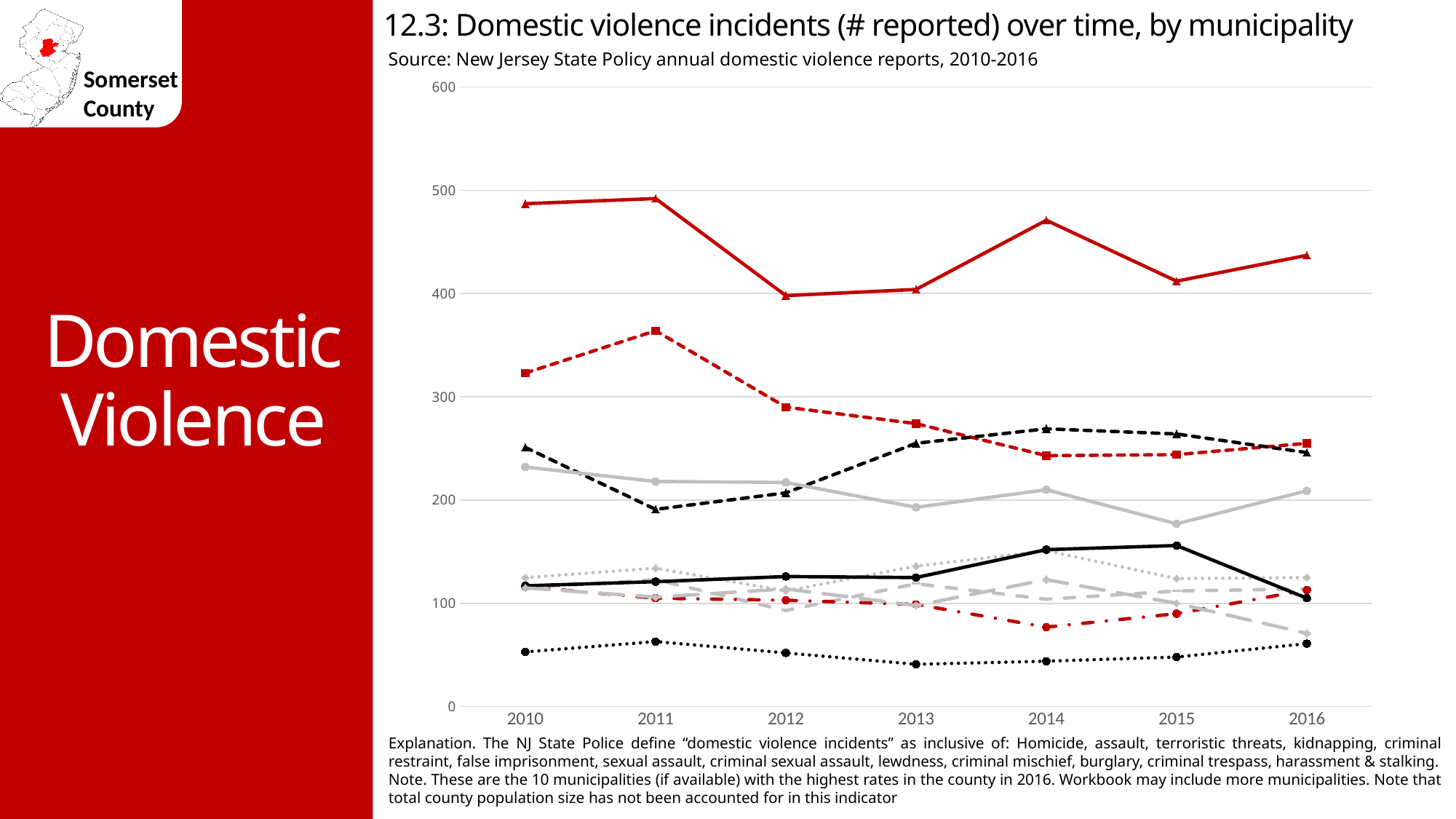
Is the value of the dashed red line with square markers in 2011 greater or less than 300? greater What is the highest value shown on the chart's y axis? 600 Is the value of the solid black line with circle markers in 2015 greater or less than 100? greater Is the value of the solid red line with triangle markers in 2015 greater or less than 500? less What is the title of the chart on the slide? 12.3: Domestic violence incidents (# reported) over time, by municipality What kind of chart is shown on the slide? line chart In which year does the dashed red line with square markers reach its highest value? 2011 Does the solid red line with triangle markers rise or fall from 2011 to 2012? fall How many years are plotted along the x axis of the chart? 7